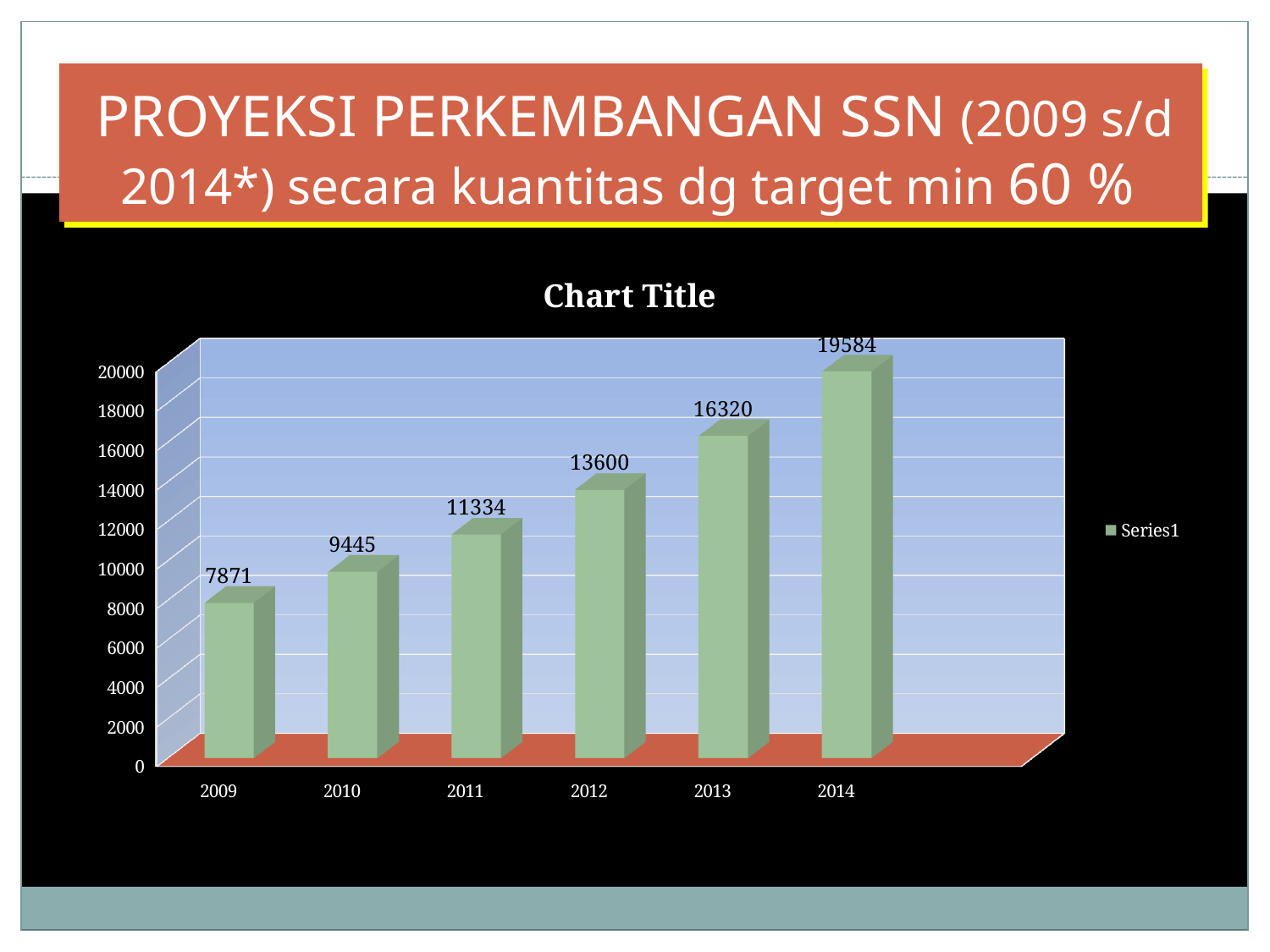
Which year has the lowest value? 2009 What is the value for 2012? 13600 What is the difference between the values for 2014 and 2013? 3264 Which year has the highest value? 2014 Is the value for 2013 greater or less than 14000? greater What is the value for 2009? 7871 What is the difference between the values for 2011 and 2010? 1889 How many years are shown on the x axis? 6 What is the value for 2014? 19584 What kind of chart is shown? bar chart Which is larger, the value for 2011 or the value for 2012? 2012 Do the values rise or fall from 2009 to 2014? rise